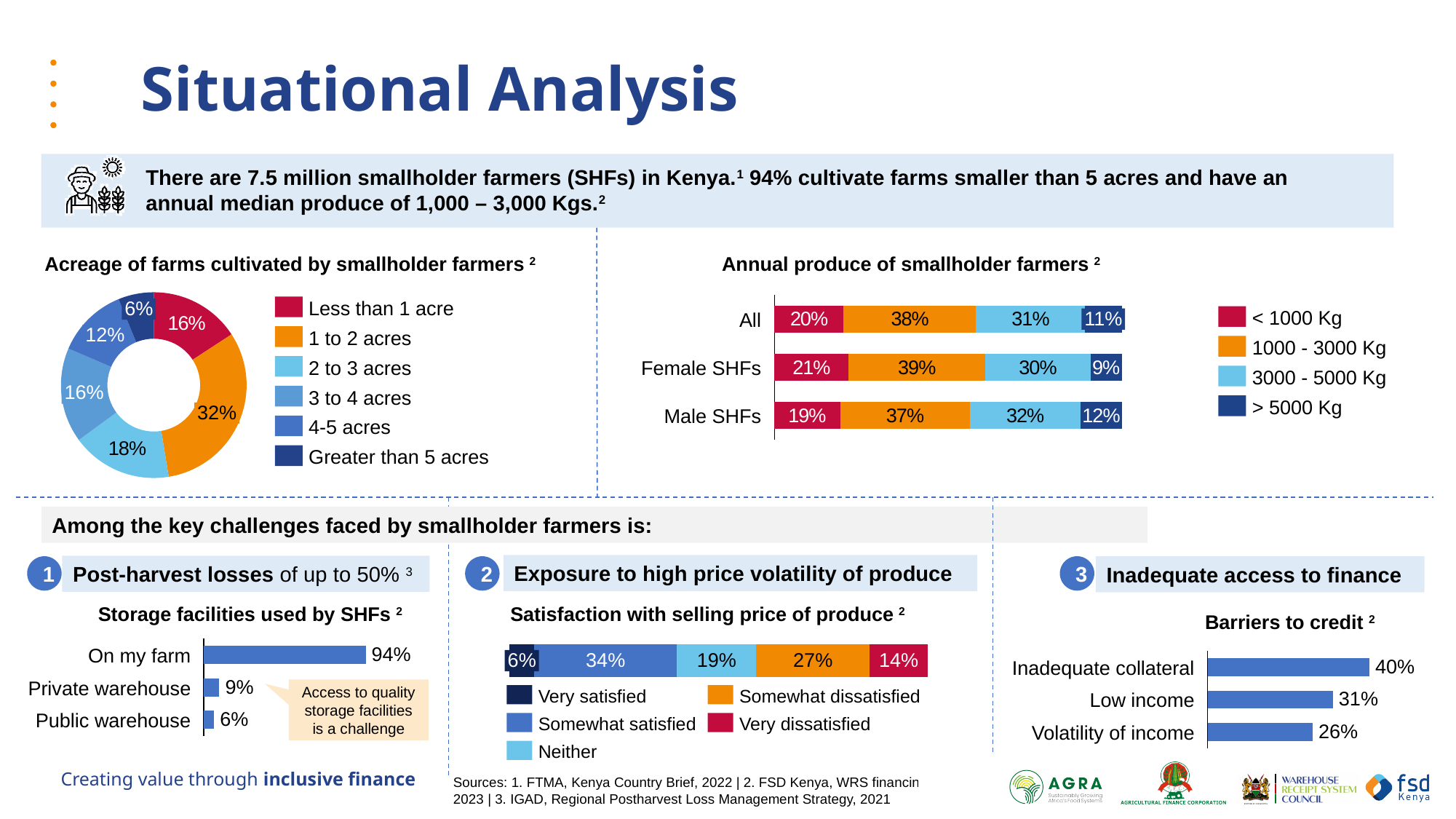
In the 'Acreage of farms cultivated by smallholder farmers' chart, what share of farms are 1 to 2 acres? 32% In the 'Satisfaction with selling price of produce' chart, what is the combined share of Somewhat dissatisfied and Very dissatisfied? 41% In the 'Storage facilities used by SHFs' chart, which is larger: Private warehouse or Public warehouse? Private warehouse In the 'Annual produce of smallholder farmers' chart, what percentage of Female SHFs produce 1000 - 3000 Kg? 39% In the 'Annual produce of smallholder farmers' chart, how many series does the legend list? 4 In the 'Barriers to credit' chart, which barrier has the highest value? Inadequate collateral In the 'Acreage of farms cultivated by smallholder farmers' chart, which category has the smallest share? Greater than 5 acres In the 'Storage facilities used by SHFs' chart, what is the value for 'On my farm'? 94% How many categories are shown in the 'Barriers to credit' chart? 3 What kind of chart is 'Acreage of farms cultivated by smallholder farmers'? Donut (pie) chart In the 'Satisfaction with selling price of produce' chart, what percentage are Somewhat dissatisfied? 27% In the 'Annual produce of smallholder farmers' chart, what is the difference between the > 5000 Kg share for Male SHFs and for Female SHFs? 3%